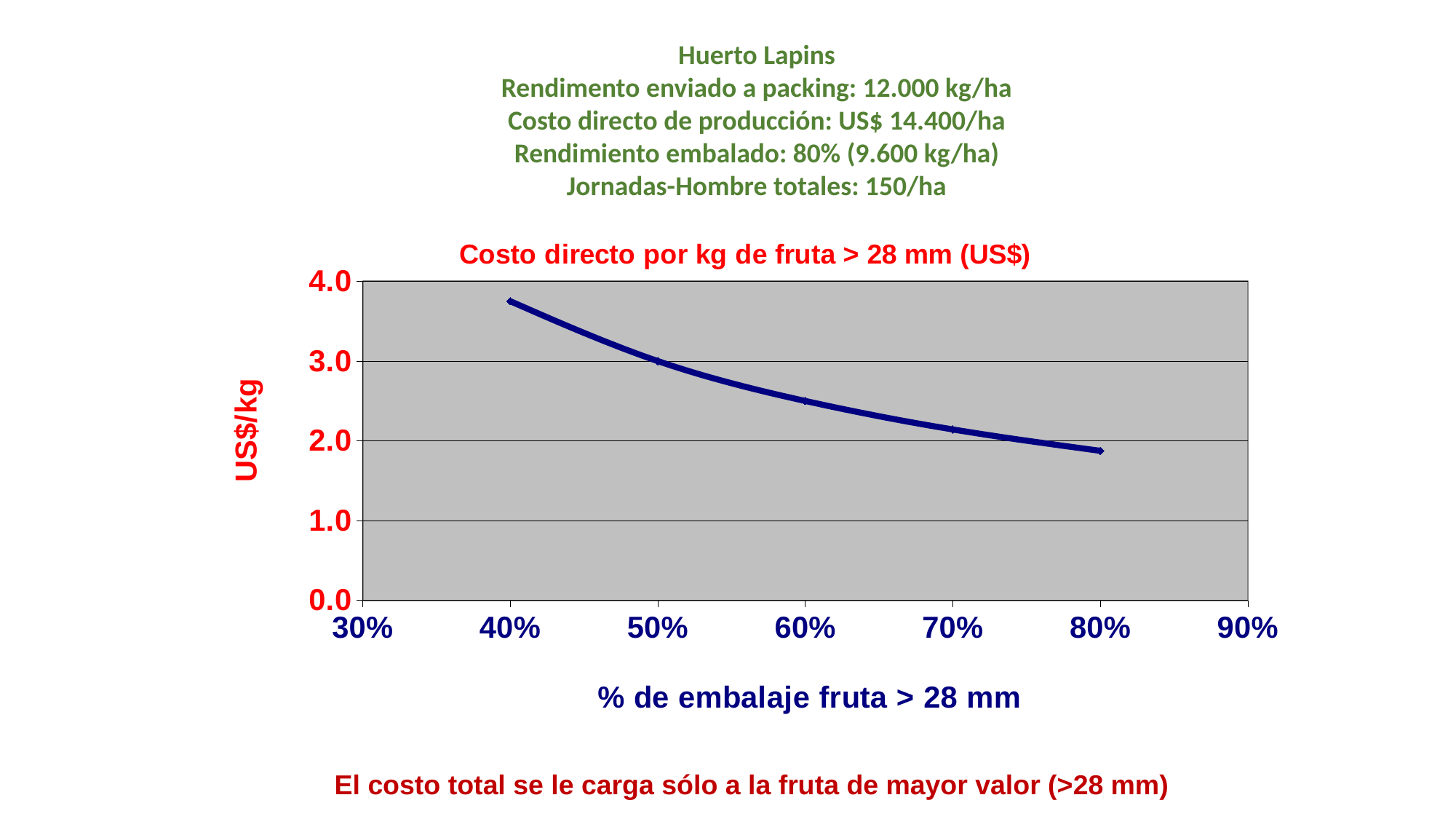
Is the value at 60% de embalaje greater or less than 2.0? greater Is the value at 70% de embalaje greater or less than 3.0? less Which has the larger cost per kg, 40% or 80% de embalaje? 40% What kind of chart is shown on the slide? line chart At which % de embalaje is the cost per kg lowest? 80% Is the value at 80% de embalaje greater or less than 2.0? less How many data points are plotted on the line? 5 Do the values rise or fall as the % de embalaje fruta > 28 mm increases along the x axis? fall What is the title of the chart? Costo directo por kg de fruta > 28 mm (US$) At which % de embalaje is the cost per kg highest? 40% What is the cost in US$/kg at 50% de embalaje fruta > 28 mm? 3.0